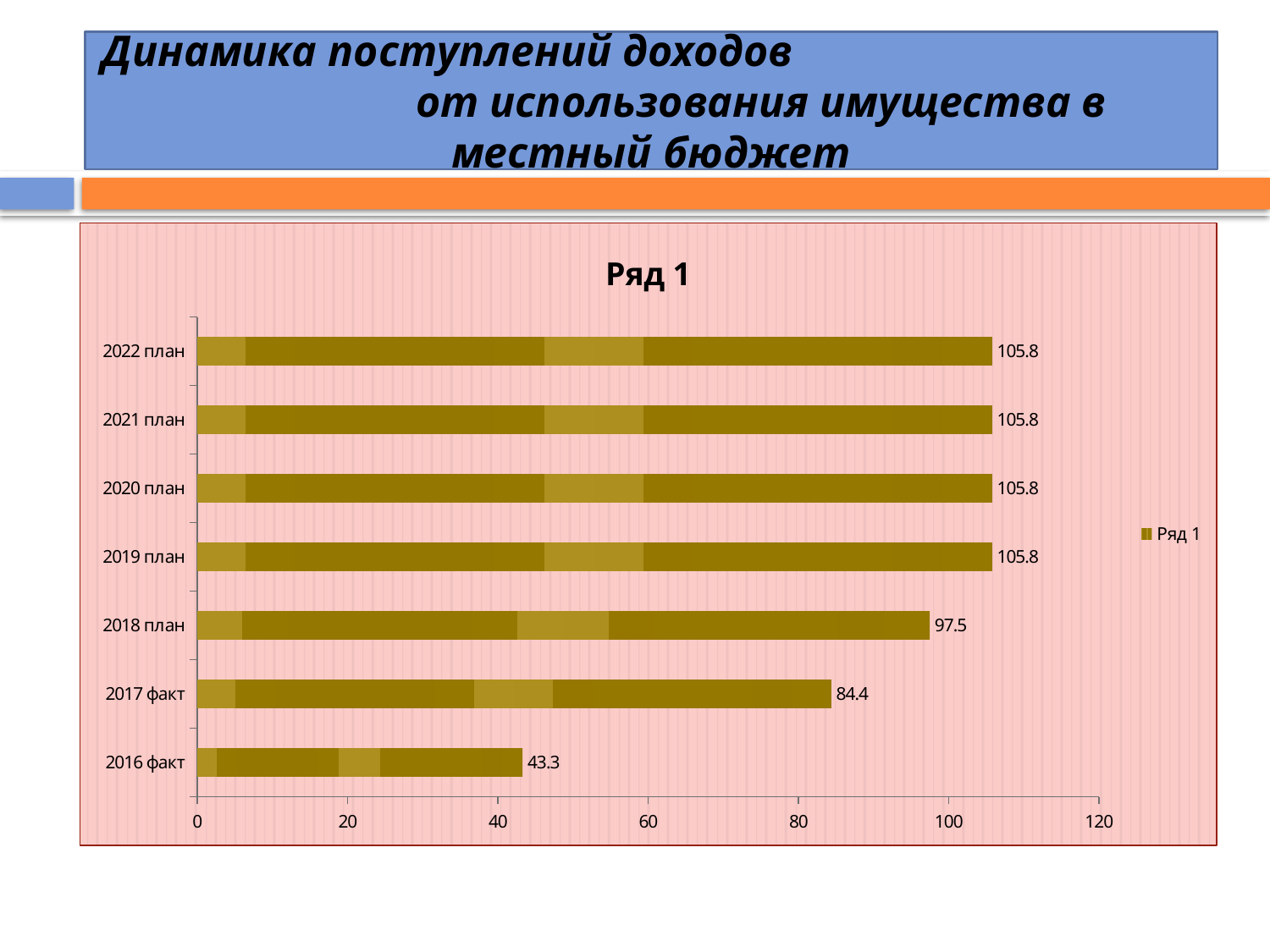
How many categories are shown on the chart? 7 What is the value for 2017 факт? 84.4 What is the difference between the values for 2017 факт and 2016 факт? 41.1 What kind of chart is shown on the slide? bar chart What is the value for 2020 план? 105.8 Which is larger, the value for 2018 план or the value for 2017 факт? 2018 план Which category has the lowest value? 2016 факт What is the difference between the values for 2019 план and 2018 план? 8.3 What is the value for 2016 факт? 43.3 Is the value for 2021 план greater or less than 100? greater What is the value for 2018 план? 97.5 What is the title of the chart? Ряд 1